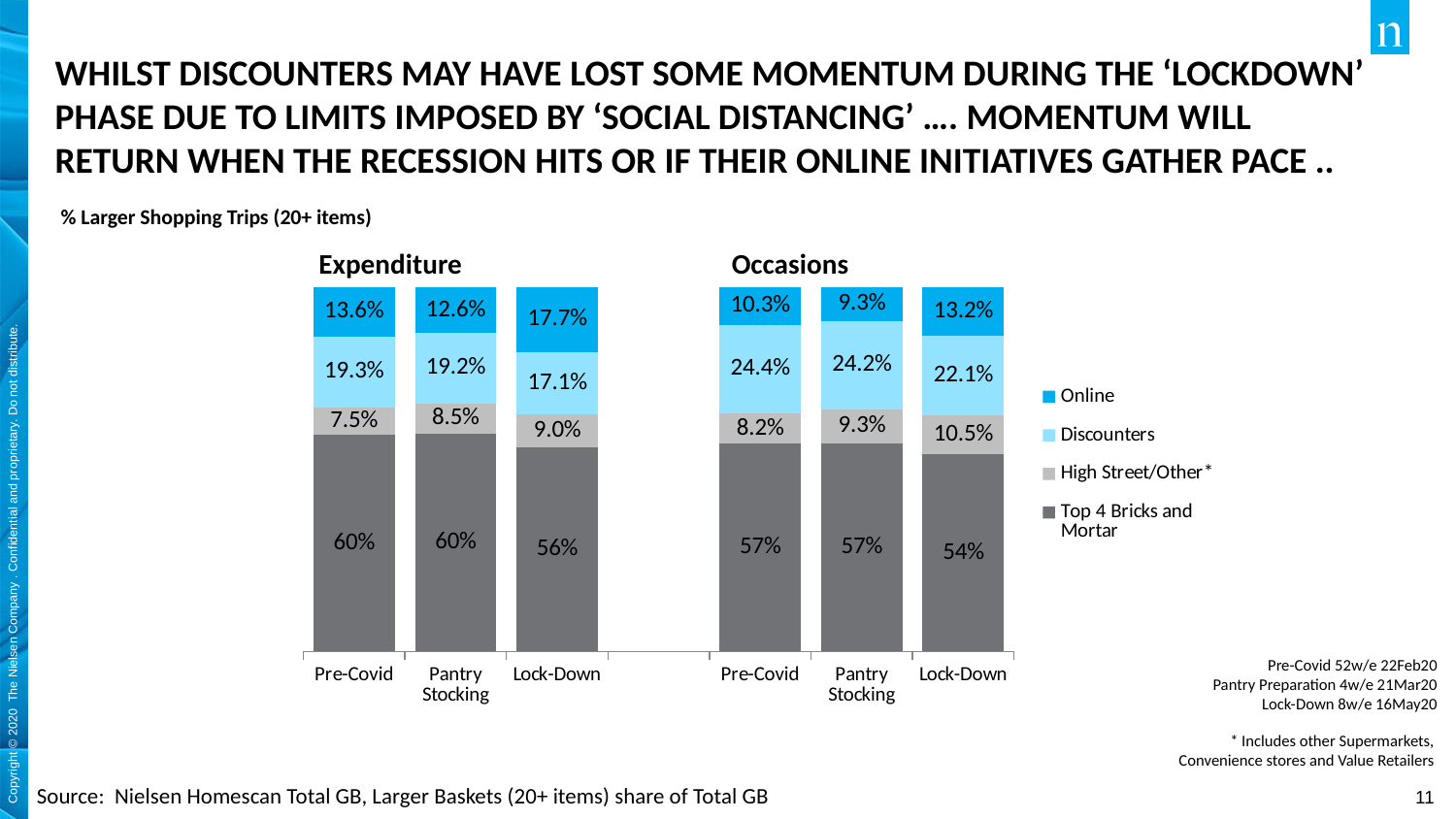
In the Expenditure chart, what is the difference between the Discounters share for Pre-Covid and for Lock-Down? 2.2% In the Expenditure chart, is the High Street/Other share larger for Pantry Stocking or for Pre-Covid? Pantry Stocking In the Occasions chart, what is the Discounters share for Pre-Covid? 24.4% In the Expenditure chart, what is the Online share for Lock-Down? 17.7% In the Occasions chart, which period has the lowest Top 4 Bricks and Mortar share? Lock-Down In the Occasions chart, what is the difference between the Online share for Lock-Down and for Pantry Stocking? 3.9% How many periods are shown on the x axis of the Occasions chart? 3 What kind of chart is the Expenditure chart? Stacked bar chart In the Occasions chart, what is the High Street/Other share for Pantry Stocking? 9.3% How many series does the legend list? 4 In the Expenditure chart, which period has the highest Online share? Lock-Down In the Expenditure chart, what is the Top 4 Bricks and Mortar share for Lock-Down? 56%